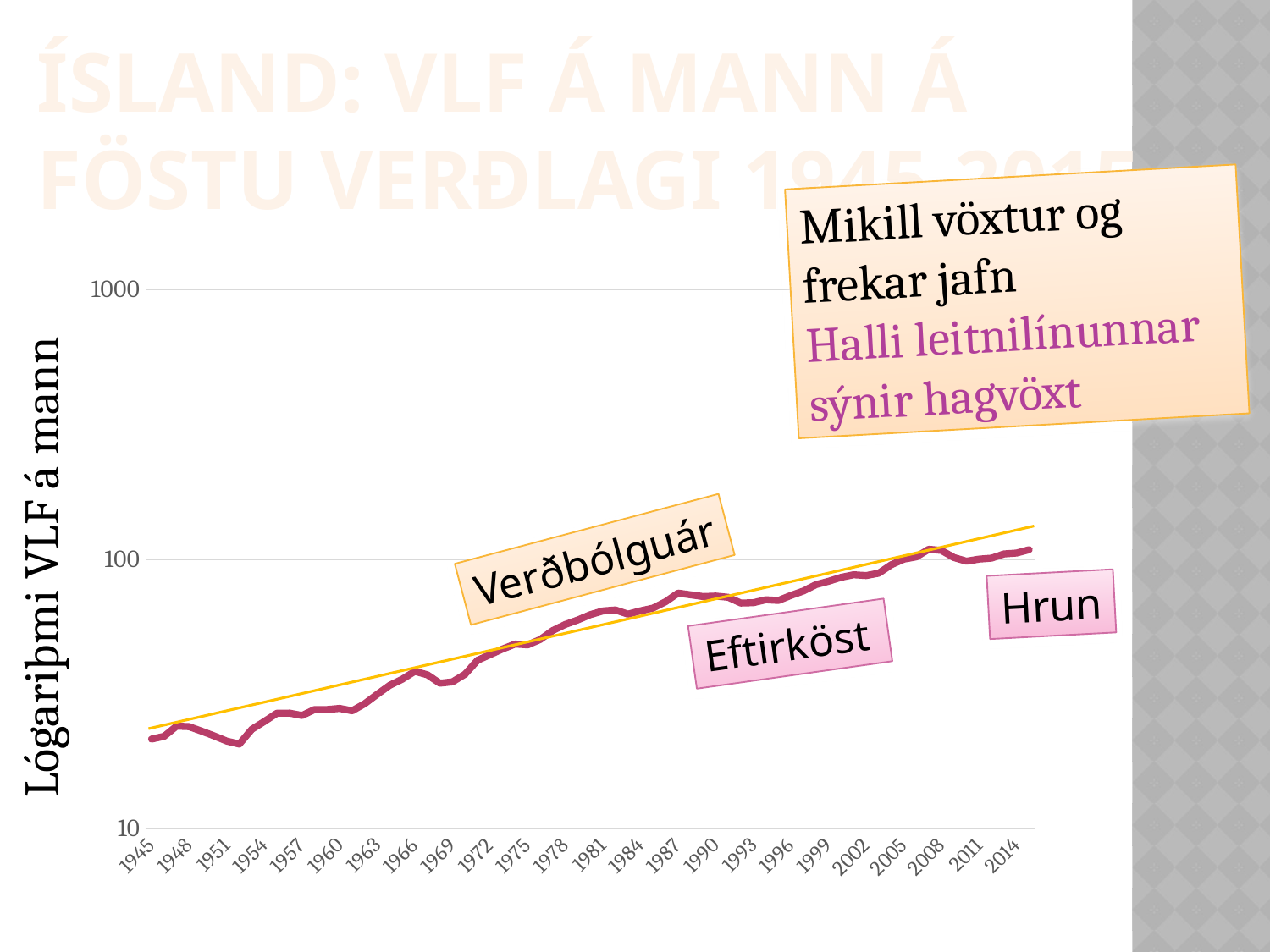
What is the first year labelled on the x axis? 1945 Is the value for 1945 greater or less than 100? less What is the last year labelled on the x axis? 2014 Is the value for 1966 greater or less than 10? greater What is the label on the y axis? Lógariþmi VLF á mann How many year labels are shown on the x axis? 24 Which year has the larger value, 1960 or 1984? 1984 What is the highest value labelled on the y axis? 1000 Which year has the larger value, 1945 or 2014? 2014 Is the value for 1990 greater or less than 100? less What kind of chart is shown on the slide? line chart Does the plotted line generally rise or fall from 1945 to 2014? rise